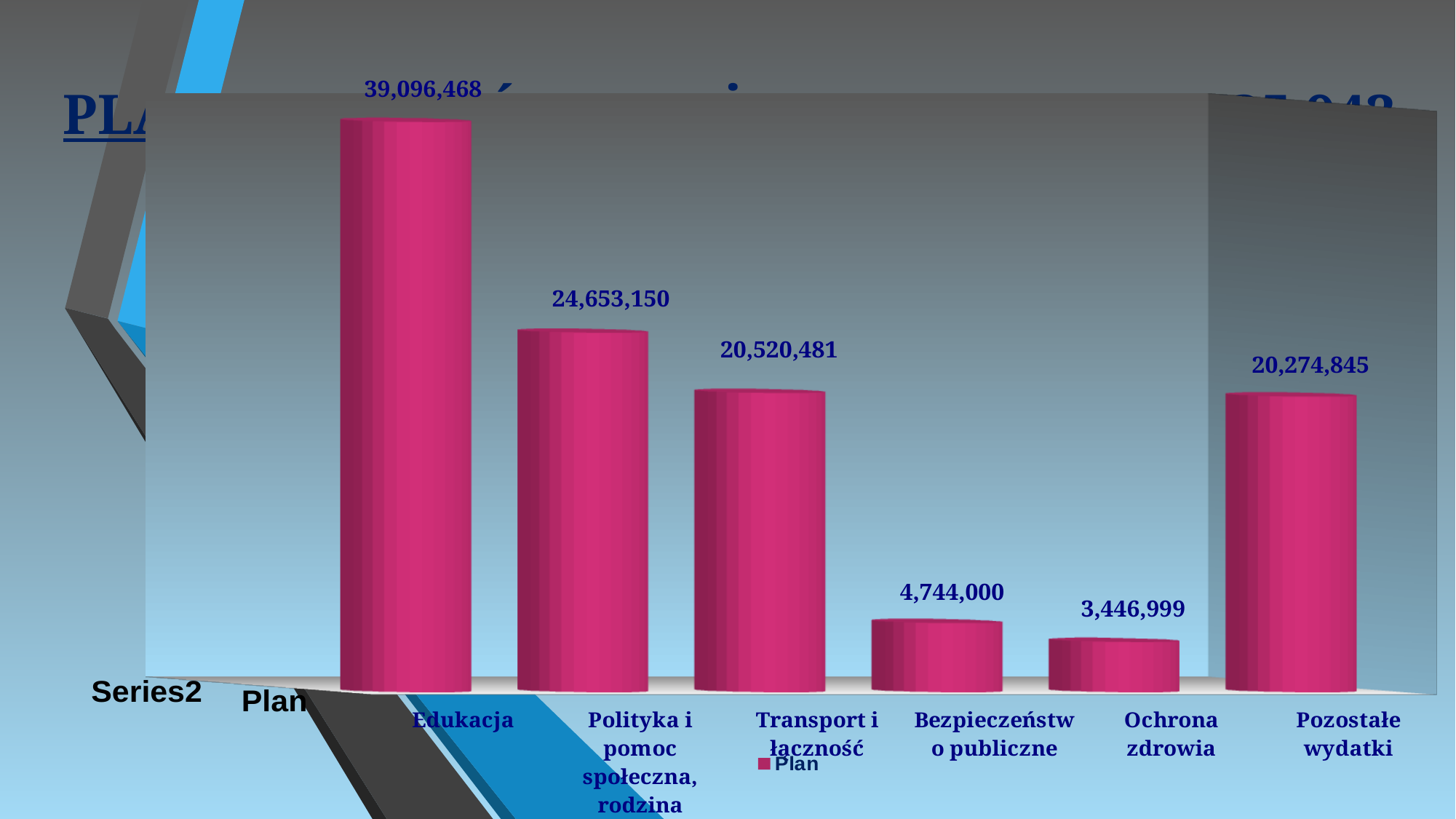
How many series does the legend list? 1 How many categories are shown on the chart? 6 What kind of chart is shown on the slide? Bar chart What is the Plan value for Bezpieczeństwo publiczne? 4,744,000 Which category has the highest Plan value? Edukacja Which category has the lowest Plan value? Ochrona zdrowia Which has the larger Plan value, Transport i łączność or Pozostałe wydatki? Transport i łączność What is the difference between the Plan values for Bezpieczeństwo publiczne and Ochrona zdrowia? 1,297,001 What is the Plan value for Pozostałe wydatki? 20,274,845 What is the Plan value for Ochrona zdrowia? 3,446,999 What is the difference between the Plan values for Edukacja and Polityka i pomoc społeczna, rodzina? 14,443,318 What is the Plan value for Edukacja? 39,096,468